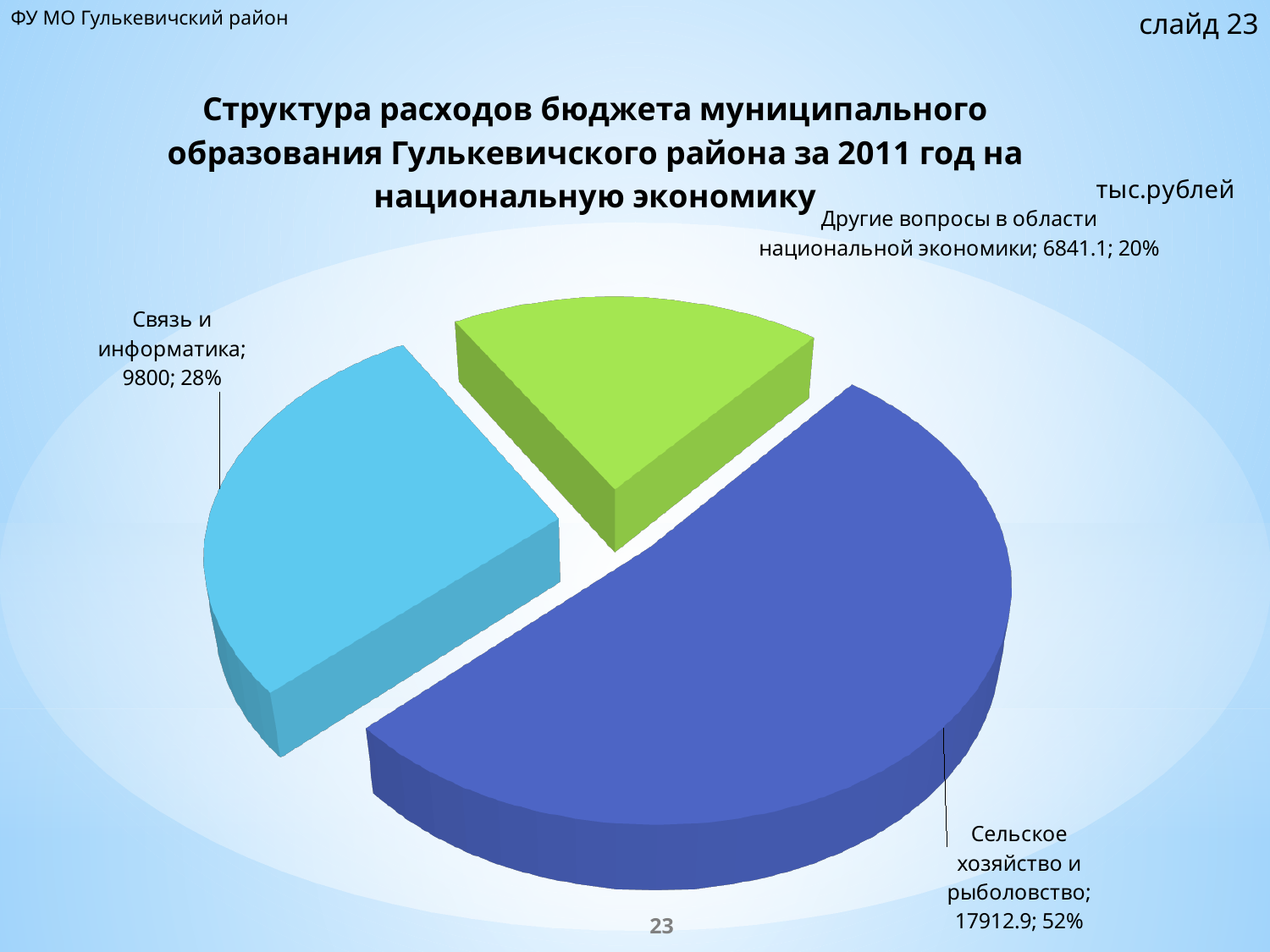
What is the value for Сельское хозяйство и рыболовство? 17912.9 What is the difference between the values for Сельское хозяйство и рыболовство and Связь и информатика? 8112.9 In what units are the values on the chart given? тыс.рублей What share of the pie does Связь и информатика represent? 28% Which category has the smallest slice? Другие вопросы в области национальной экономики How many slices does the pie chart have? 3 What is the value for Другие вопросы в области национальной экономики? 6841.1 Which category has the largest slice? Сельское хозяйство и рыболовство What is the value for Связь и информатика? 9800 What share of the pie does Сельское хозяйство и рыболовство represent? 52% Which is larger: the value for Связь и информатика or for Другие вопросы в области национальной экономики? Связь и информатика What kind of chart is shown on the slide? Pie chart